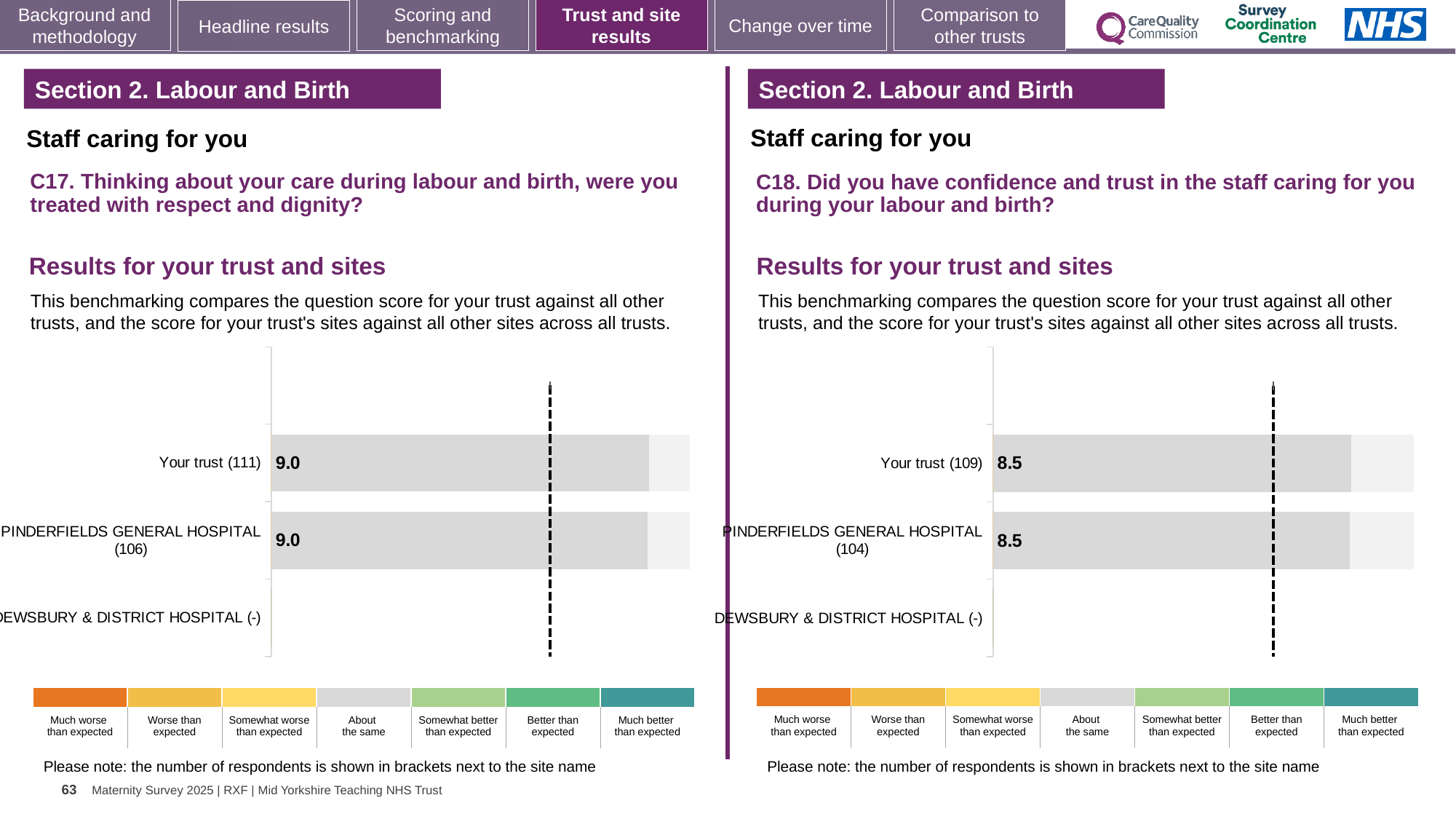
What type of chart is used on the right chart (C18)? Bar chart On the left chart (C17), what is the score for Pinderfields General Hospital (106)? 9.0 What is the difference between the Your trust score on the left chart (C17) and the Your trust score on the right chart (C18)? 0.5 On the left chart (C17), which site has no score shown (marked with a dash)? Dewsbury & District Hospital On the right chart (C18), how many respondents are shown in brackets for Your trust? 109 On the right chart (C18), what is the score for Pinderfields General Hospital (104)? 8.5 What is the difference between the Your trust score and the Pinderfields General Hospital score on the left chart (C17)? 0.0 On the left chart (C17), how many respondents are shown in brackets for Pinderfields General Hospital? 106 On the right chart (C18), what is the score for Your trust (109)? 8.5 On the left chart (C17), what is the score for Your trust (111)? 9.0 Which is larger: the Your trust score on the left chart (C17) or the Your trust score on the right chart (C18)? Left chart (C17) How many sites or categories are listed on the left chart (C17)? 3